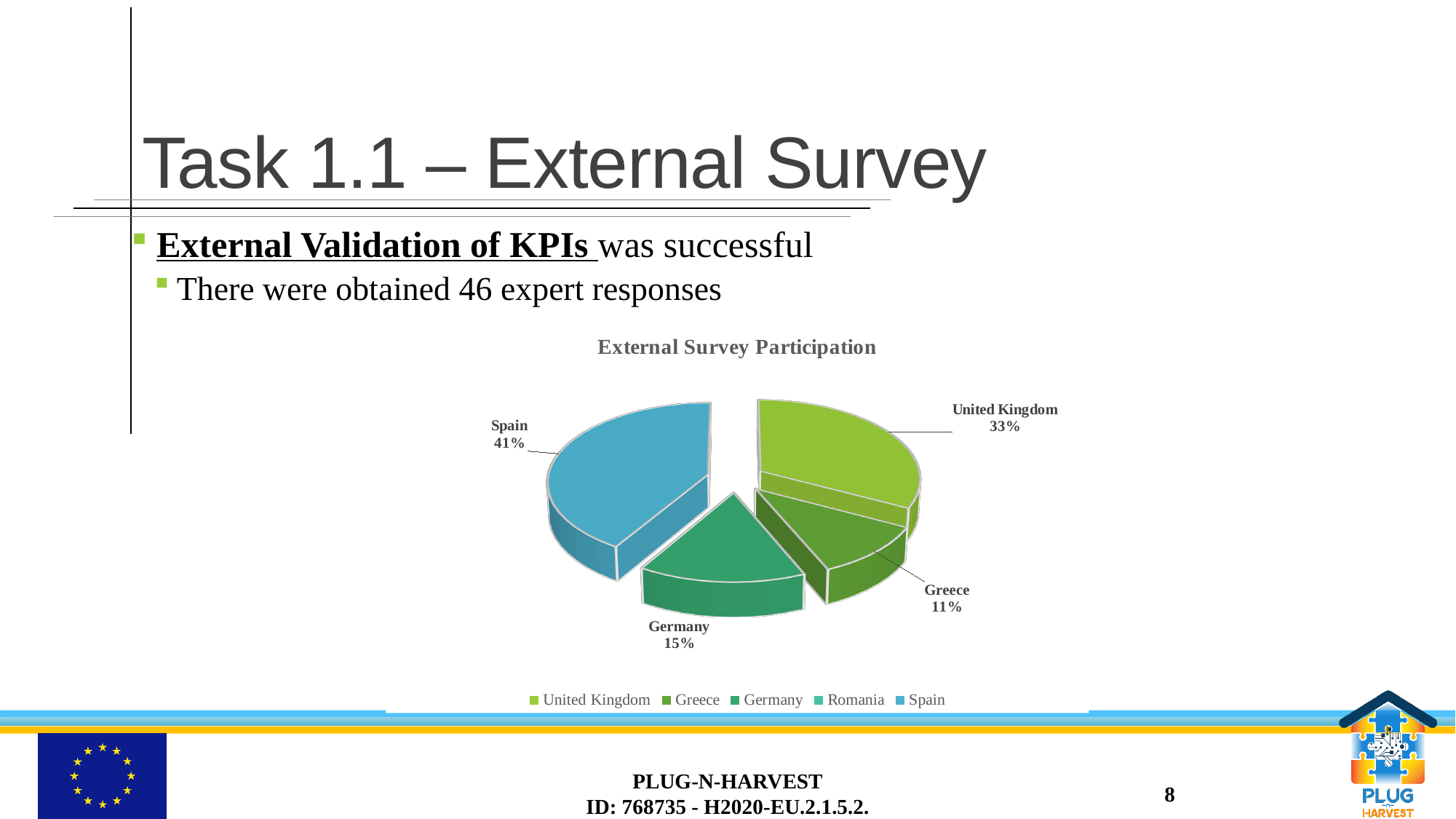
What share of external survey participation does Germany have? 15% What is the title of the chart? External Survey Participation What is the difference in percentage points between Spain's share and the United Kingdom's share? 8 What share of external survey participation does the United Kingdom have? 33% Which labelled slice has the smallest share of external survey participation? Greece Which has a larger share of external survey participation, Germany or Greece? Germany What share of external survey participation does Greece have? 11% How many entries does the legend list? 5 How many slices with percentage labels are shown in the pie chart? 4 What kind of chart is shown on the slide? pie chart What share of external survey participation does Spain have? 41% Which country has the largest share of external survey participation? Spain